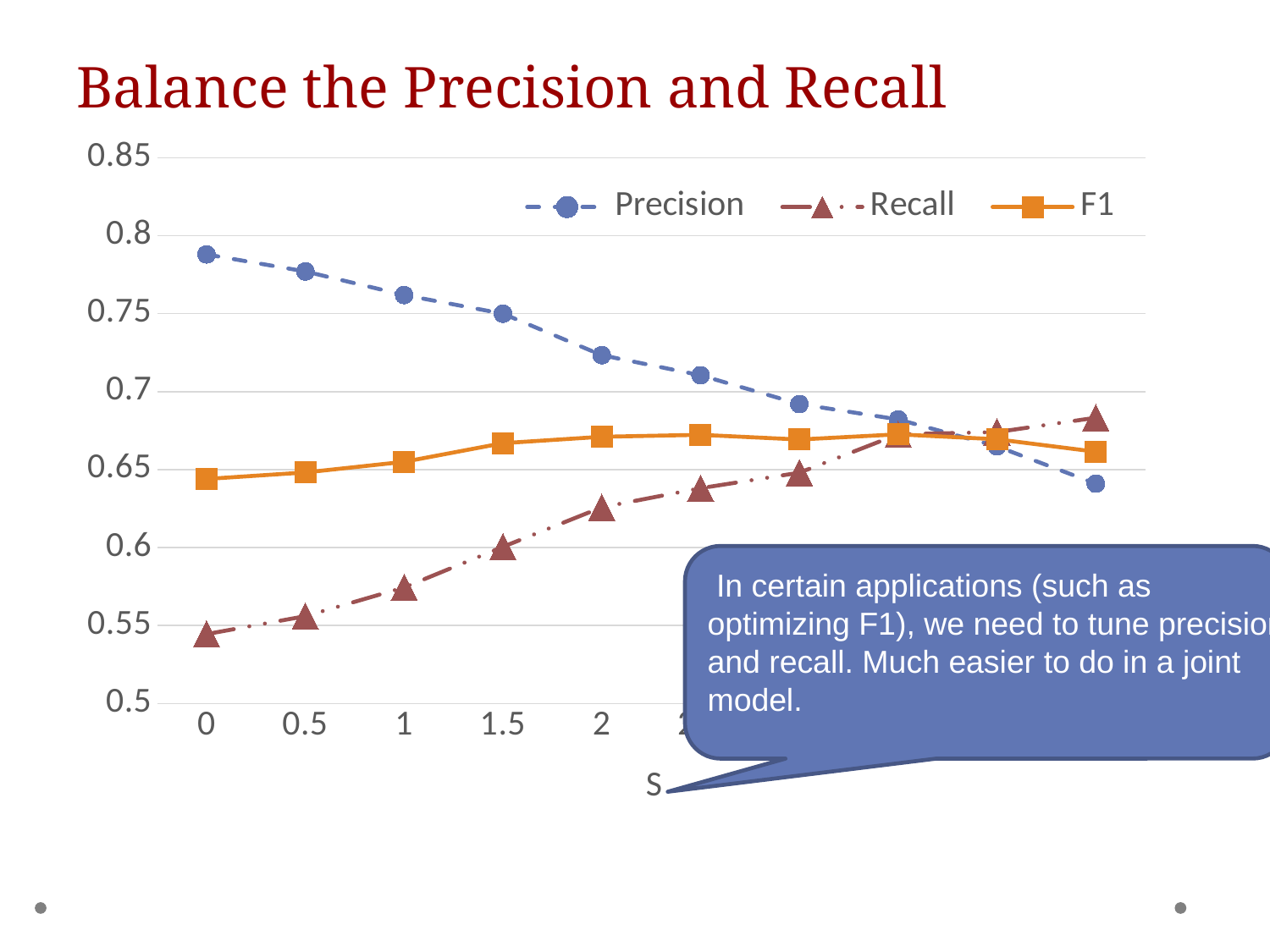
How many series does the legend list? 3 Is the Recall value at S = 2 greater or less than 0.6? greater At S = 0, which series has the higher value, Precision or Recall? Precision What kind of chart is shown on the slide? line chart At S = 1, which series has the higher value, F1 or Recall? F1 Does the Precision series rise or fall as S increases along the x axis? fall Is the Recall value at S = 0 greater or less than 0.6? less What is the title of the chart on the slide? Balance the Precision and Recall Does the Recall series rise or fall as S increases along the x axis? rise Is the Precision value at S = 0 greater or less than 0.75? greater Which series are listed in the legend? Precision, Recall, F1